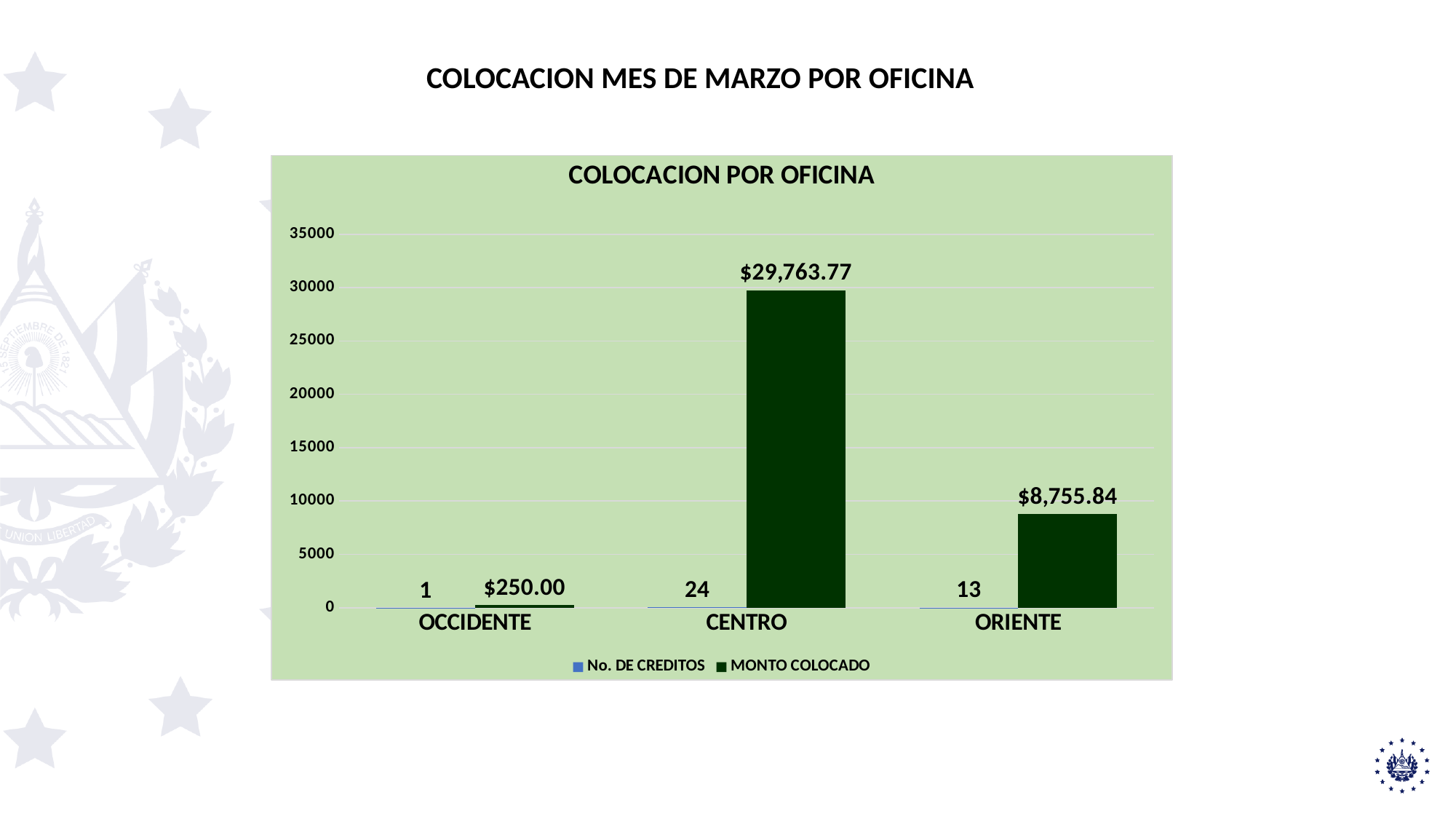
What type of chart is shown? Bar chart How many offices are shown on the x axis? 3 Which is larger, the MONTO COLOCADO for ORIENTE or for OCCIDENTE? ORIENTE How many series does the legend list? 2 What is the MONTO COLOCADO value for OCCIDENTE? $250.00 Which office has the lowest No. DE CREDITOS? OCCIDENTE What is the No. DE CREDITOS value for CENTRO? 24 What is the MONTO COLOCADO value for ORIENTE? $8,755.84 What is the MONTO COLOCADO value for CENTRO? $29,763.77 What is the No. DE CREDITOS value for ORIENTE? 13 Which office has the highest MONTO COLOCADO? CENTRO What is the difference in No. DE CREDITOS between CENTRO and ORIENTE? 11